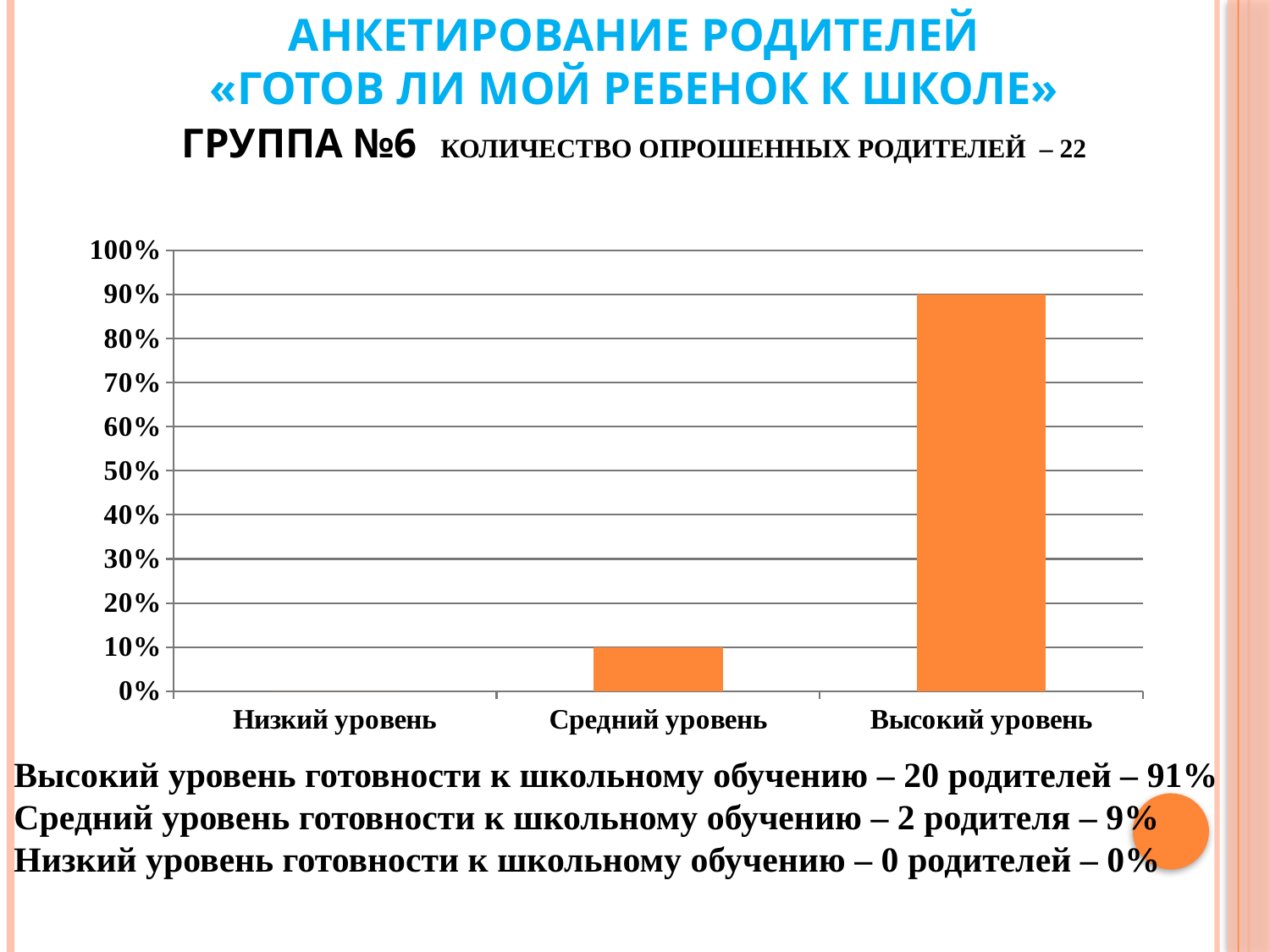
Is the value for Средний уровень greater or less than 20%? less Do the bar values rise or fall moving from left to right along the x axis? rise Which is larger, the bar for Средний уровень or the bar for Высокий уровень? Высокий уровень What colour are the bars in the chart? orange How many categories are shown on the x axis of the chart? 3 What is the highest value shown on the chart's vertical axis? 100% What kind of chart is shown on the slide? bar chart Which category has the lowest bar in the chart? Низкий уровень Which category has the highest bar in the chart? Высокий уровень Is the value for Высокий уровень greater or less than 80%? greater What is the value shown for Низкий уровень in the chart? 0% Is the value for Высокий уровень greater or less than 50%? greater